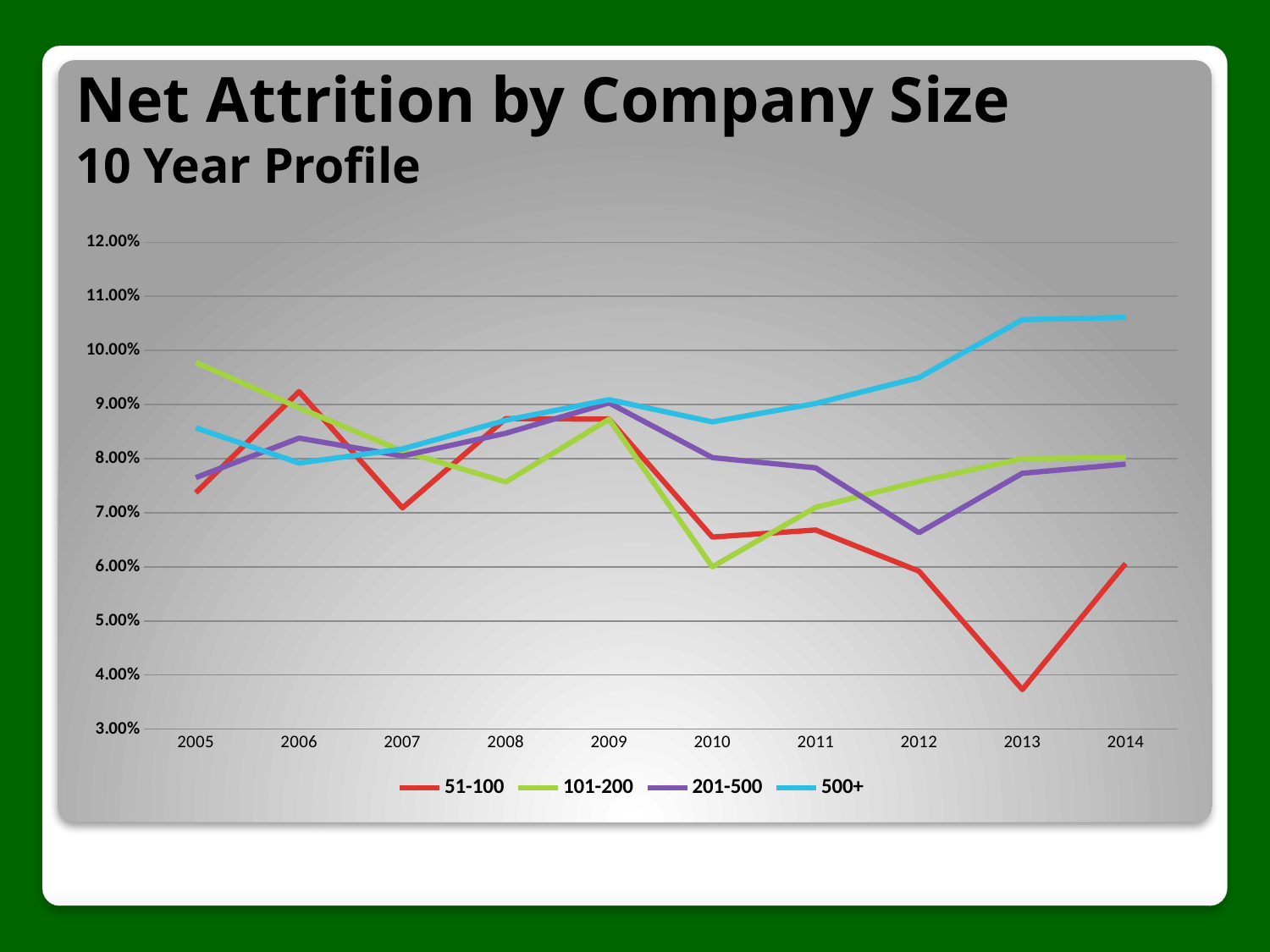
Does the 500+ series rise or fall from 2011 to 2014? rise What kind of chart is shown on the slide? line chart How many years are plotted along the x axis? 10 Is the value for the 201-500 series in 2012 greater or less than 7.00%? less Which series has the highest value in 2014? 500+ How many series does the legend list? 4 Is the value for the 101-200 series in 2005 greater or less than 9.00%? greater Which series has the lowest value in 2013? 51-100 Is the value for the 500+ series in 2013 greater or less than 10.00%? greater What is the title of the chart on the slide? Net Attrition by Company Size 10 Year Profile Which series has the highest value in 2005? 101-200